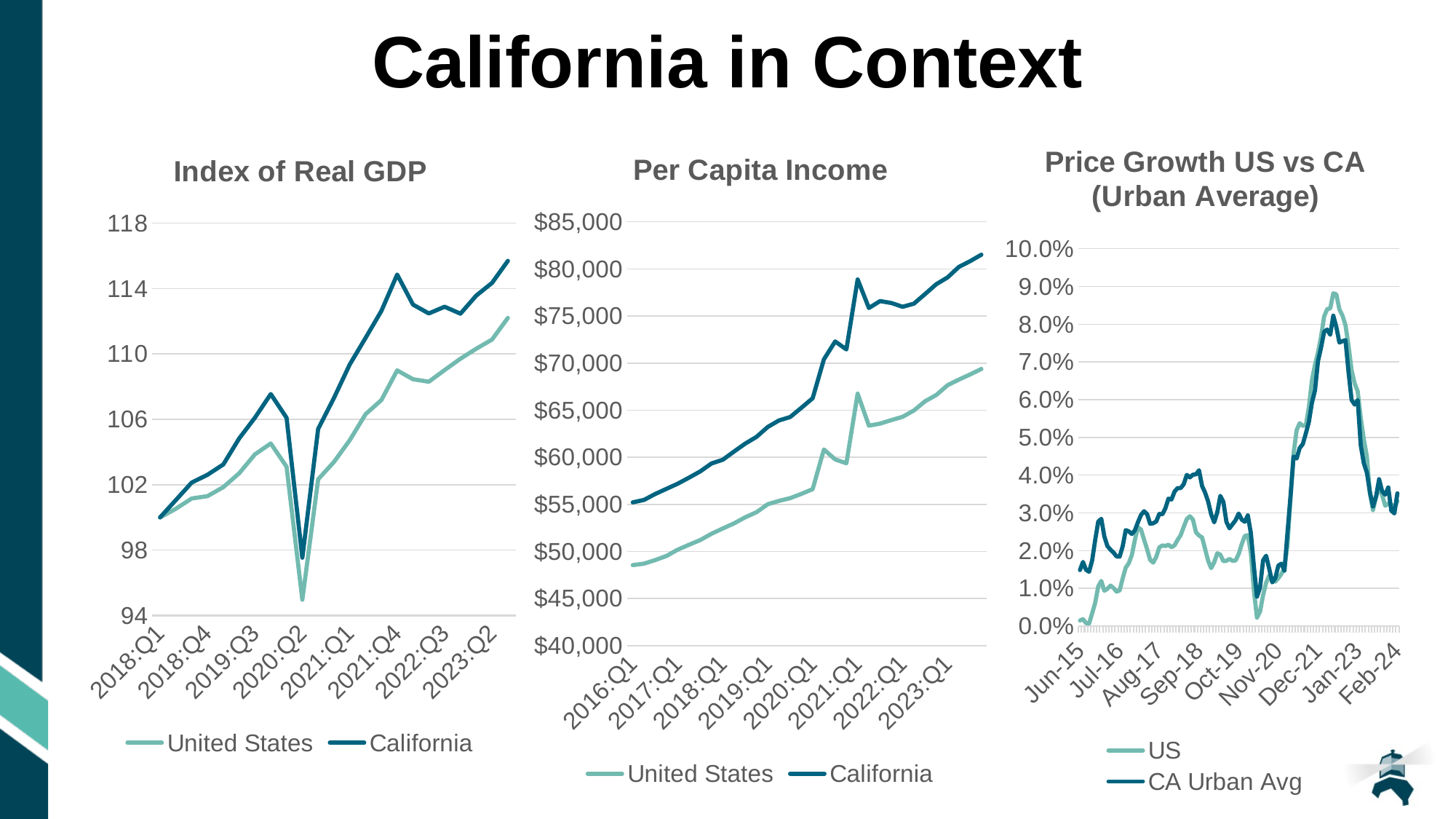
In the 'Per Capita Income' chart, which series is higher throughout the period, United States or California? California In the 'Per Capita Income' chart, is the final value for California greater or less than $80,000? greater What kind of chart is the 'Index of Real GDP' chart? line chart In the 'Index of Real GDP' chart, which series is higher at 2023:Q2, United States or California? California In the 'Price Growth US vs CA (Urban Average)' chart, is the peak value for US greater or less than 8.0%? greater In the 'Price Growth US vs CA (Urban Average)' chart, what are the two series named in the legend? US and CA Urban Avg In the 'Per Capita Income' chart, is the value for the United States at 2016:Q1 greater or less than $50,000? less In the 'Price Growth US vs CA (Urban Average)' chart, which series reaches the higher peak, US or CA Urban Avg? US How many series does the legend of the 'Per Capita Income' chart list? 2 In the 'Per Capita Income' chart, do the values for California generally rise or fall from 2016:Q1 to 2023:Q1? rise